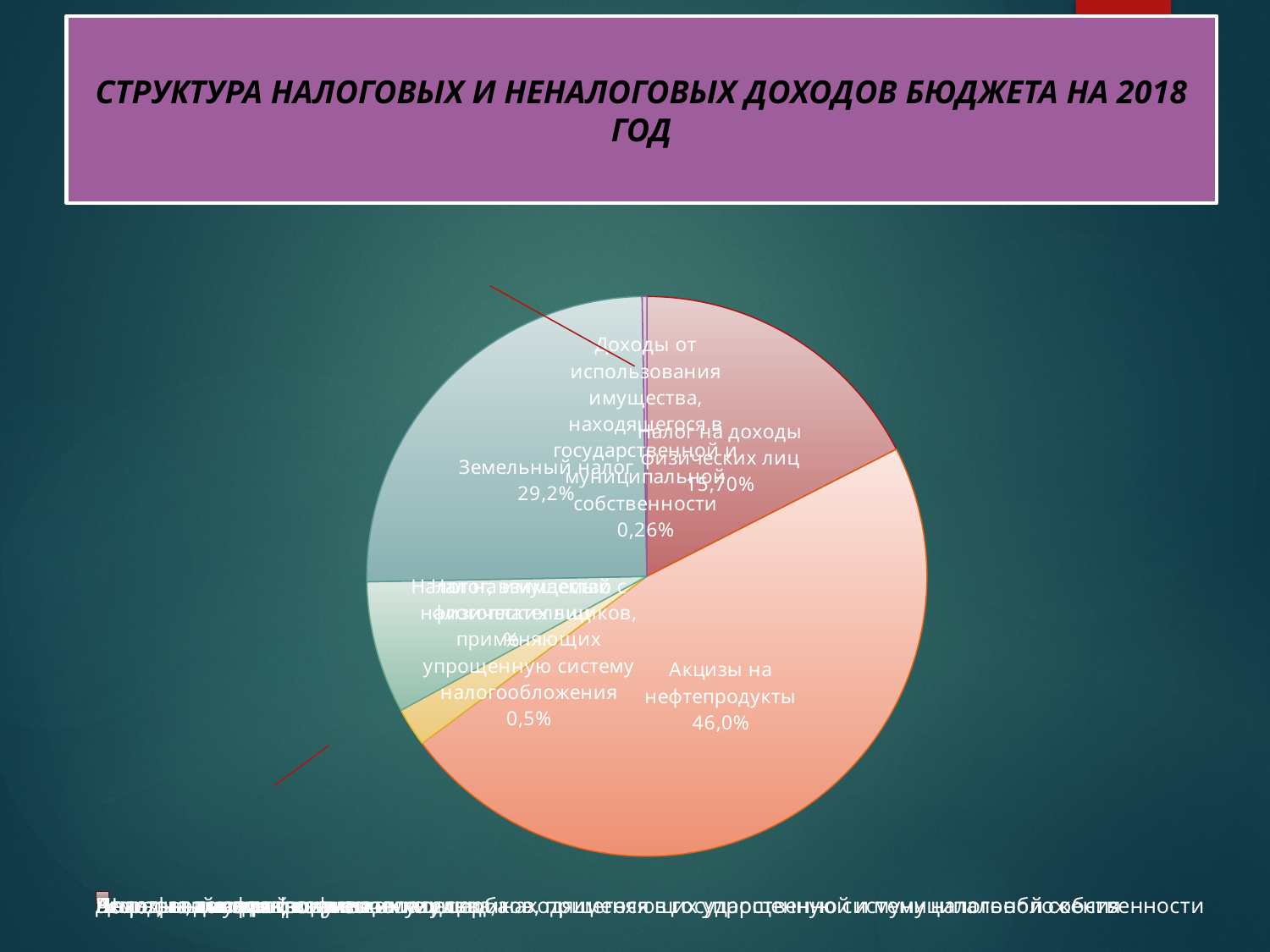
Which category has the smallest slice of the pie? Доходы от использования имущества, находящегося в государственной и муниципальной собственности What share of the pie does "Акцизы на нефтепродукты" have? 46,0% What kind of chart is shown on the slide? pie chart How many slices does the pie chart have? 6 Which is larger: the share for "Земельный налог" or the share for "Налог на доходы физических лиц"? Земельный налог What is the title of the slide containing the chart? СТРУКТУРА НАЛОГОВЫХ И НЕНАЛОГОВЫХ ДОХОДОВ БЮДЖЕТА НА 2018 ГОД What is the difference in percentage points between the share for "Акцизы на нефтепродукты" and the share for "Земельный налог"? 16,8 What share of the pie does "Доходы от использования имущества, находящегося в государственной и муниципальной собственности" have? 0,26% What share of the pie does "Налог, взимаемый с налогоплательщиков, применяющих упрощенную систему налогообложения" have? 0,5% Which category has the largest slice of the pie? Акцизы на нефтепродукты